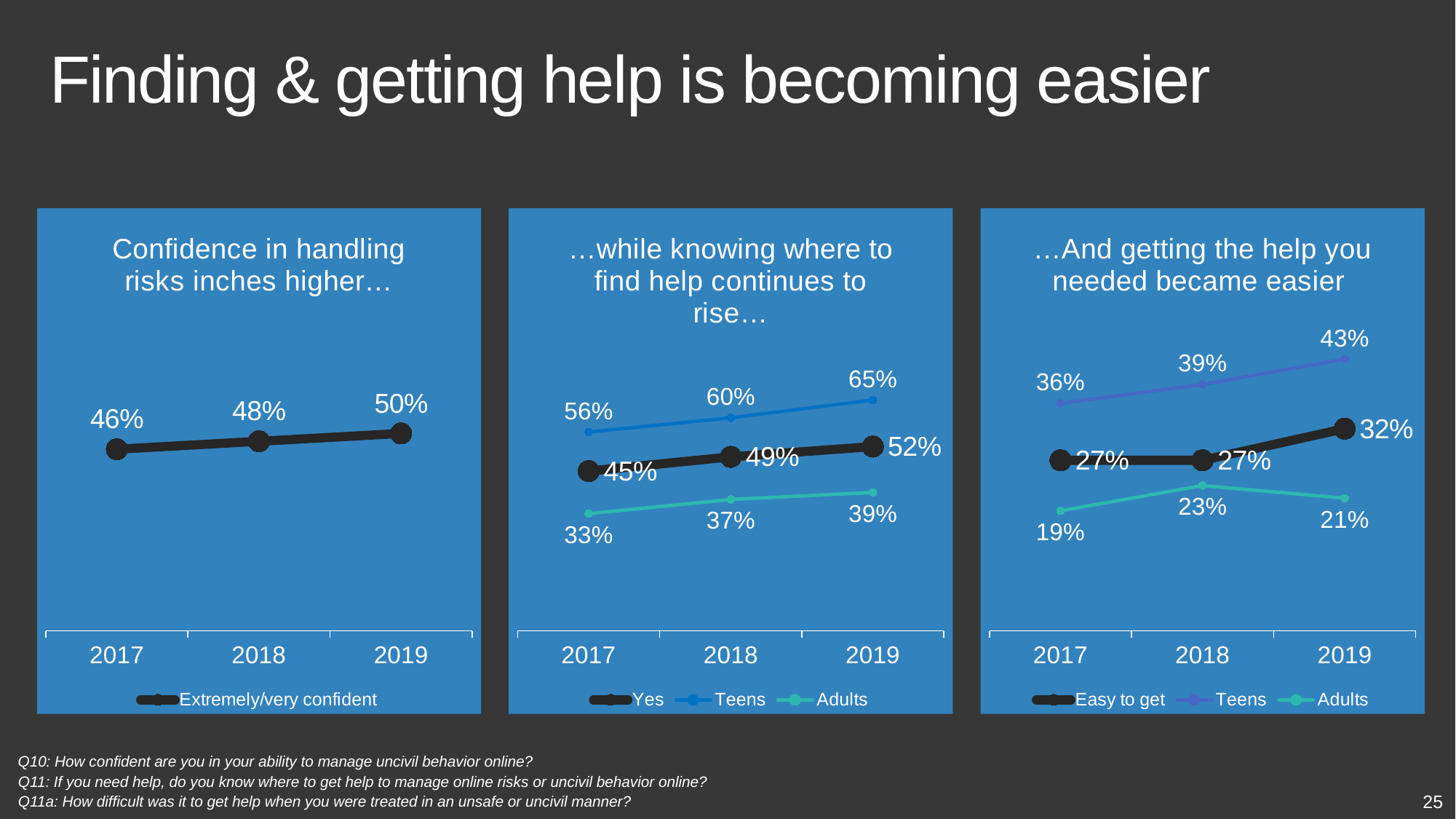
In the middle chart titled '…while knowing where to find help continues to rise…', how many series does the legend list? 3 In the middle chart titled '…while knowing where to find help continues to rise…', which series has the lowest value in 2017? Adults In the left chart titled 'Confidence in handling risks inches higher…', what is the value for 2019? 50% In the left chart titled 'Confidence in handling risks inches higher…', what is the difference between the 2019 and 2017 values? 4% How many years are shown on the x axis of the right chart titled '…And getting the help you needed became easier'? 3 In the right chart titled '…And getting the help you needed became easier', which series has the highest value in 2019? Teens In the right chart titled '…And getting the help you needed became easier', is the Easy to get value for 2019 larger or smaller than the Easy to get value for 2018? larger In the middle chart titled '…while knowing where to find help continues to rise…', what is the Teens value for 2018? 60% What kind of chart is the left chart titled 'Confidence in handling risks inches higher…'? line chart In the middle chart titled '…while knowing where to find help continues to rise…', does the Yes series rise or fall from 2017 to 2019? rise In the right chart titled '…And getting the help you needed became easier', what is the difference between the Teens and Adults values in 2019? 22% In the right chart titled '…And getting the help you needed became easier', what is the Adults value for 2018? 23%